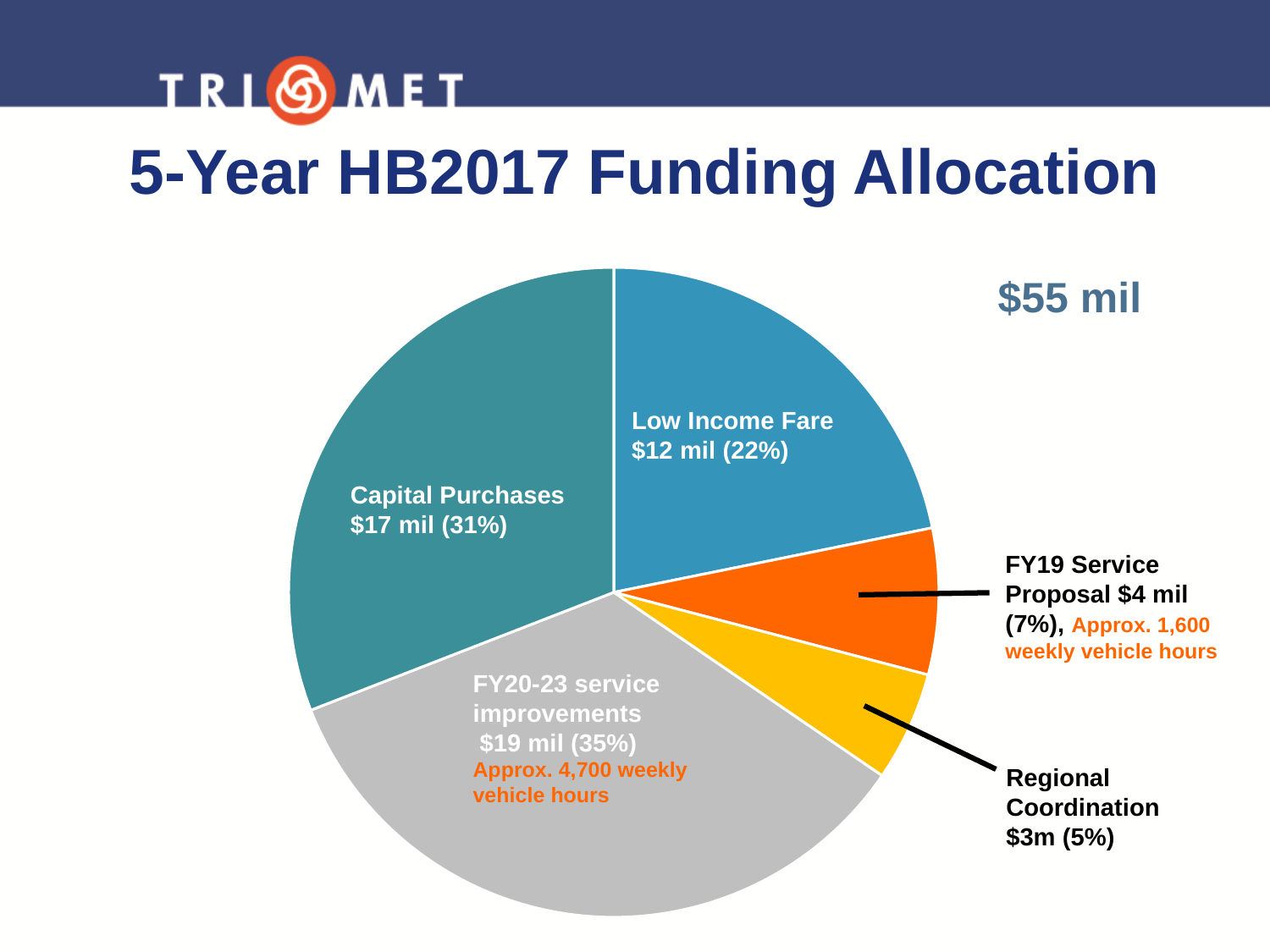
What is the funding amount for Capital Purchases? $17 mil What is the funding amount for Low Income Fare? $12 mil What share of the pie does Regional Coordination represent? 5% What is the difference in funding between Capital Purchases and Low Income Fare? $5 mil Which receives more funding, FY19 Service Proposal or Regional Coordination? FY19 Service Proposal What is the total funding amount shown on the slide? $55 mil What share of the pie does FY20-23 service improvements represent? 35% Which category receives the largest funding allocation? FY20-23 service improvements Which category receives the smallest funding allocation? Regional Coordination What kind of chart is shown on the slide? pie chart How many slices does the pie chart have? 5 What is the title of the slide? 5-Year HB2017 Funding Allocation